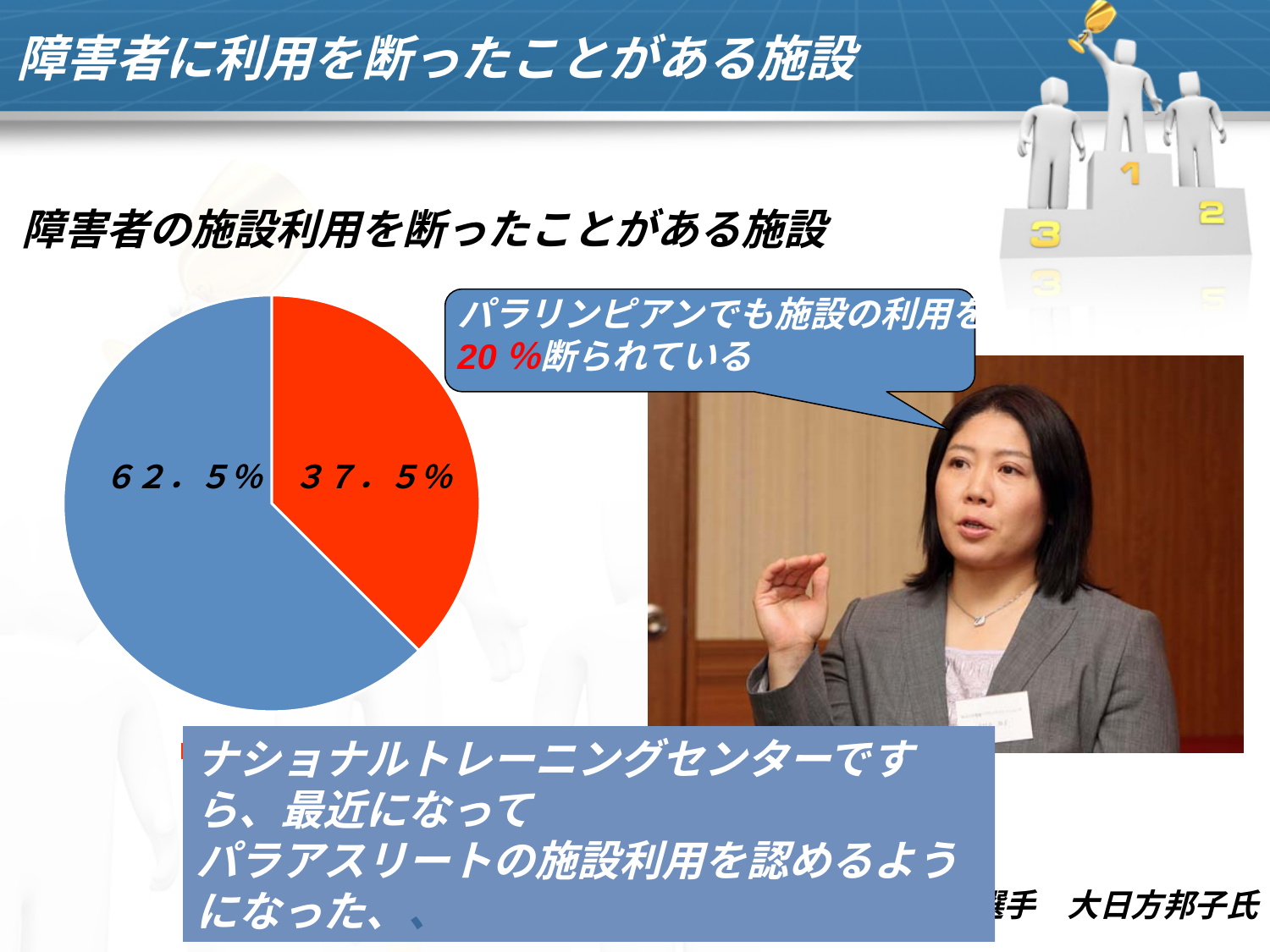
What do the two slices of the pie chart add up to? 100% What percentage is shown for the red slice of the pie chart? 37.5% What is the title written above the pie chart? 障害者の施設利用を断ったことがある施設 What share of the pie does the red slice represent? 37.5% How many slices does the pie chart have? 2 What kind of chart is shown on the slide? Pie chart What percentage is shown for the blue slice of the pie chart? 62.5% What two colours are used for the slices of the pie chart? Blue and red What is the difference in percentage points between the blue slice and the red slice? 25 percentage points Which slice of the pie chart is the largest? The blue slice (62.5%) Which is larger, the blue slice or the red slice of the pie chart? The blue slice Which slice of the pie chart is the smallest? The red slice (37.5%)